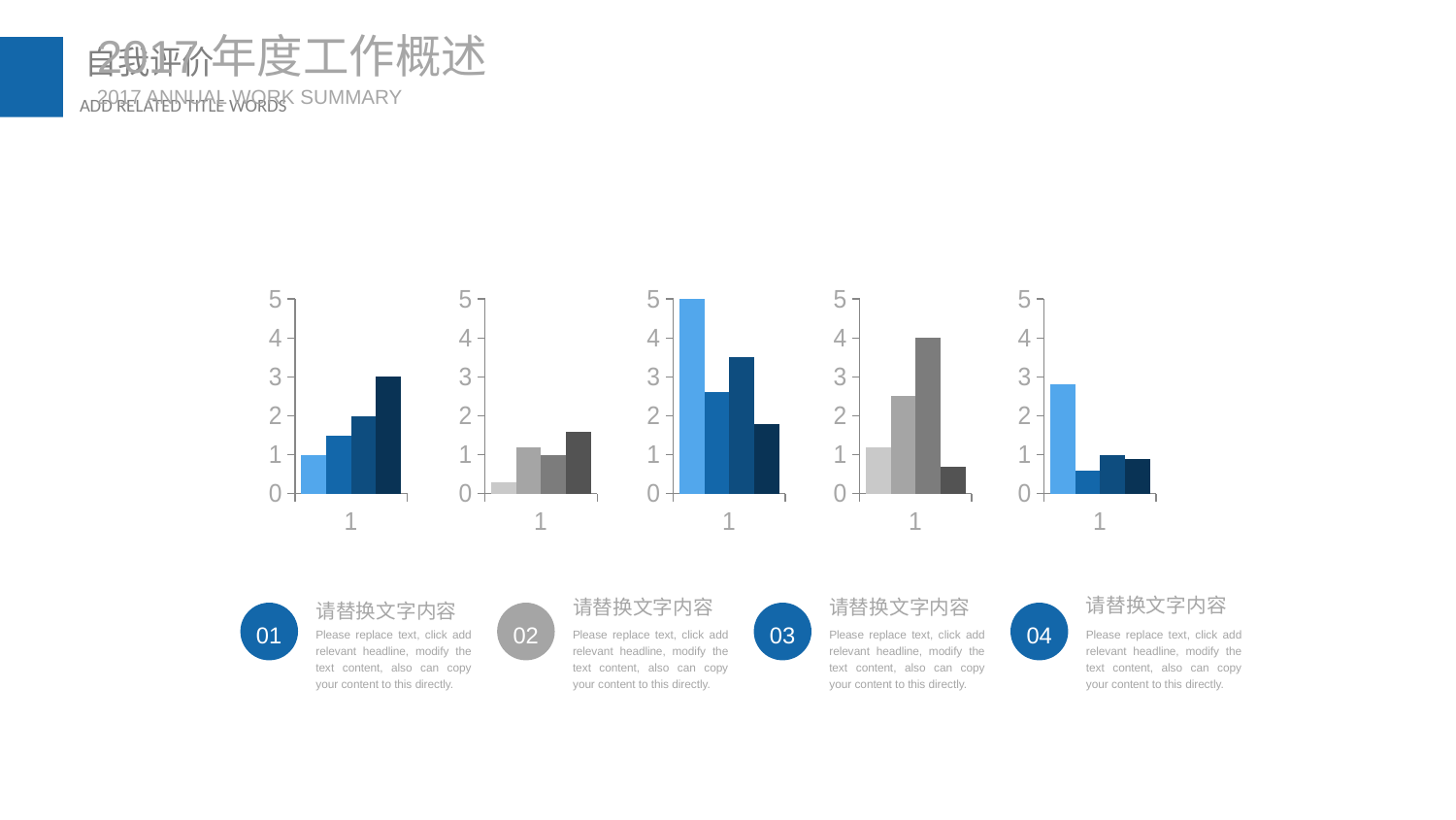
How many bars does the middle chart show? 4 In the fourth chart from the left, what value does the tallest (third, dark grey) bar reach? 4 In the leftmost chart, what is the difference between the tallest bar and the shortest bar? 2 In the middle chart, which bar is the lowest: the first, second, third or fourth? the fourth What kind of chart is the leftmost chart on the slide? bar chart In the second chart from the left, is the value of the first (lightest grey) bar greater or less than 1? less In the middle chart, what value does the tallest (first, light blue) bar reach? 5 How many separate bar charts are shown on the slide? 5 In the rightmost chart, is the value of the first (light blue) bar greater or less than 2? greater In the leftmost chart, what value does the tallest (rightmost, darkest) bar reach? 3 In the fourth chart from the left, is the value of the last (darkest) bar greater or less than 1? less In the leftmost chart, what value does the first (lightest blue) bar reach? 1